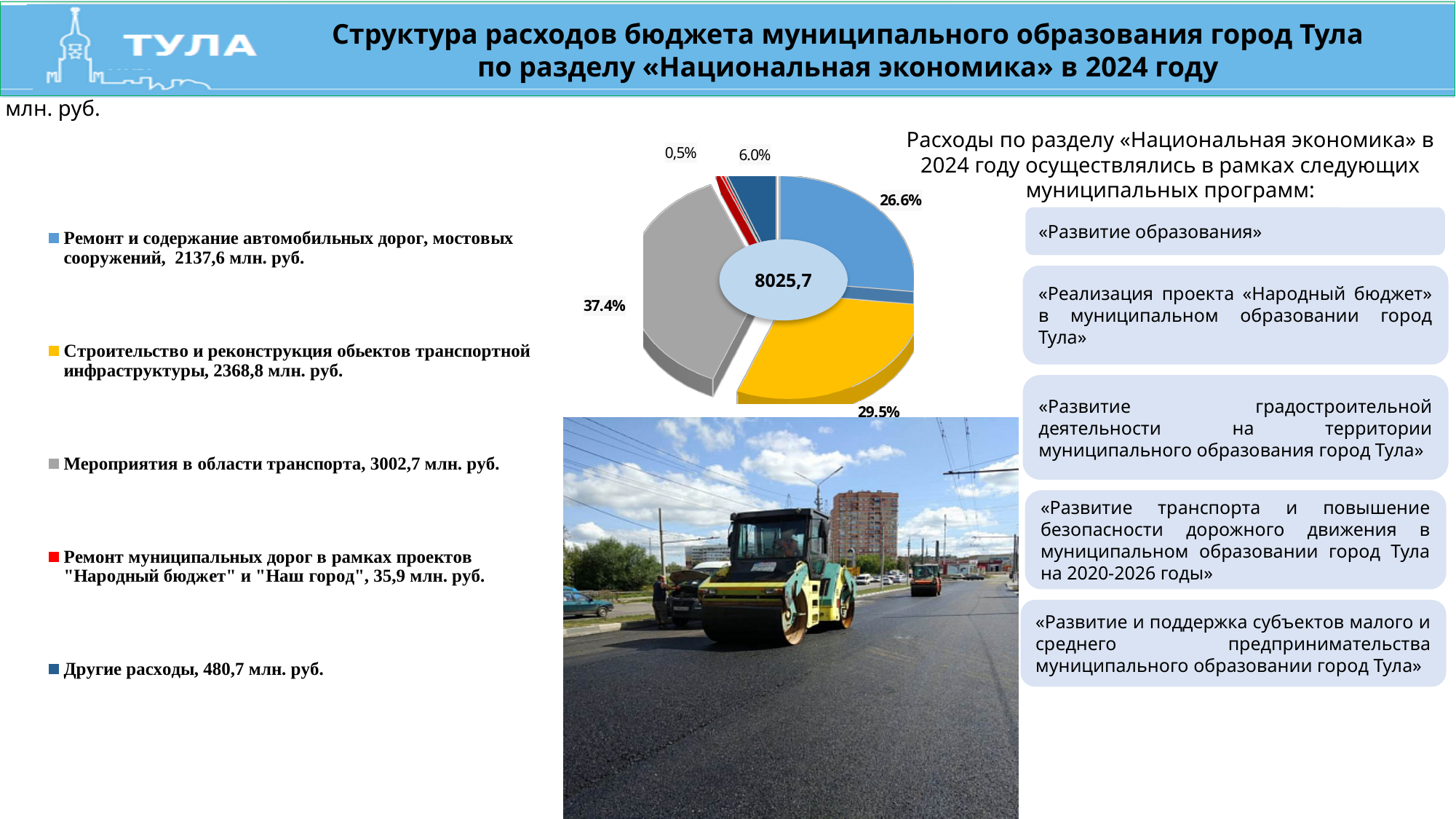
What colour is the slice for "Другие расходы" in the pie chart? dark blue What total value is shown in the centre of the pie chart? 8025,7 Which category has the smallest slice of the pie? Ремонт муниципальных дорог в рамках проектов "Народный бюджет" и "Наш город" What share of the pie does "Ремонт и содержание автомобильных дорог, мостовых сооружений" take? 26.6% What kind of chart is shown on the slide? pie chart What share of the pie does "Другие расходы" take? 6.0% How many slices does the pie chart have? 5 What share of the pie does "Строительство и реконструкция объектов транспортной инфраструктуры" take? 29.5% Which category has the largest slice of the pie? Мероприятия в области транспорта What is the value in млн. руб. for "Мероприятия в области транспорта"? 3002,7 млн. руб. Which is larger: the slice for "Строительство и реконструкция объектов транспортной инфраструктуры" or the slice for "Ремонт и содержание автомобильных дорог, мостовых сооружений"? Строительство и реконструкция объектов транспортной инфраструктуры